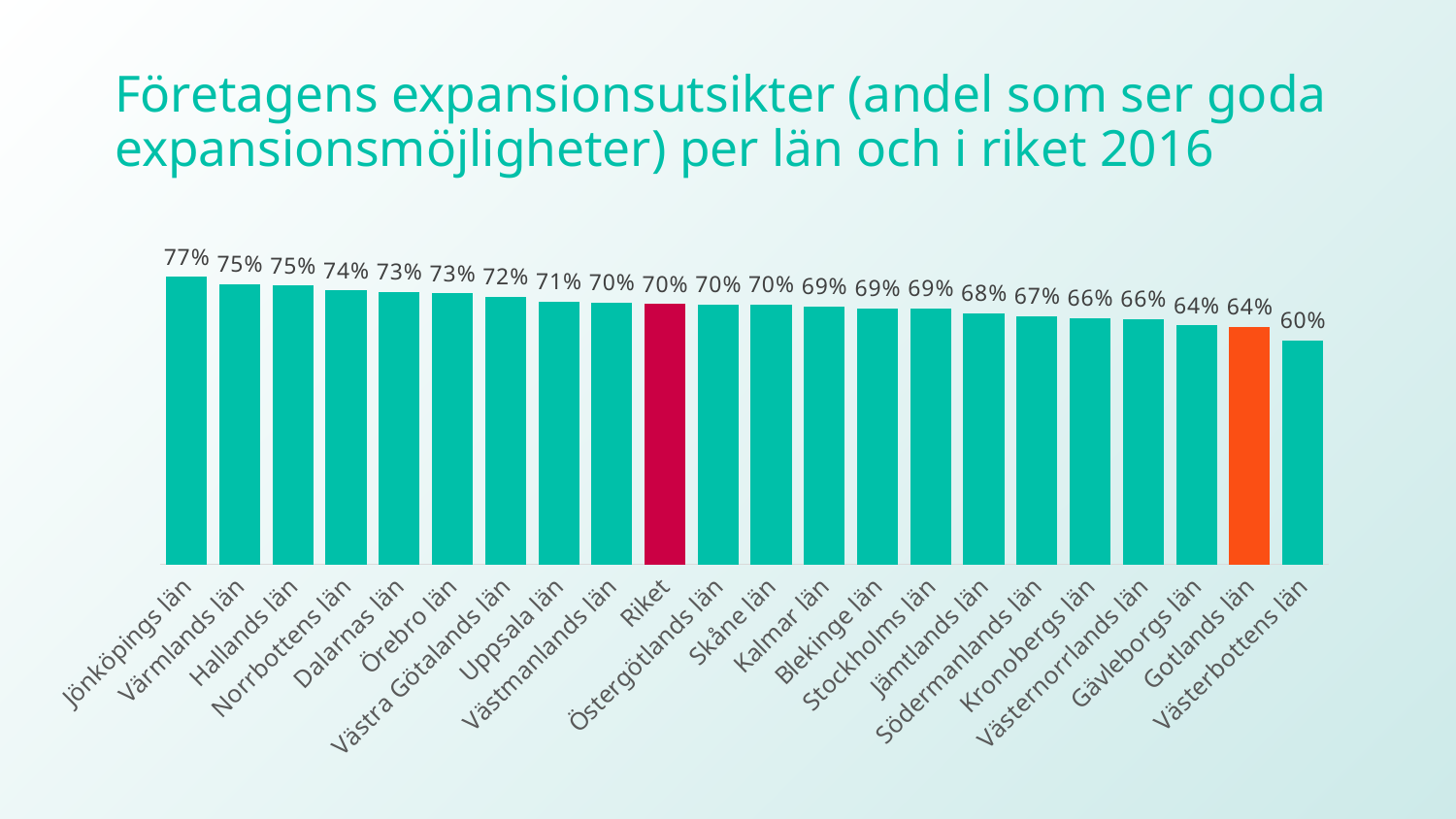
Which category has the lowest value? Västerbottens län What is the value for Riket? 70% What is the value for Jönköpings län? 77% Which bar is coloured orange? Gotlands län What is the value for Gotlands län? 64% Which is larger, the value for Norrbottens län or the value for Jämtlands län? Norrbottens län How many bars are shown in the chart? 22 What is the value for Stockholms län? 69% What kind of chart is shown on the slide? Bar chart Which category has the highest value? Jönköpings län Do the values rise or fall from left to right along the x axis? Fall What is the difference between the values for Jönköpings län and Västerbottens län? 17%